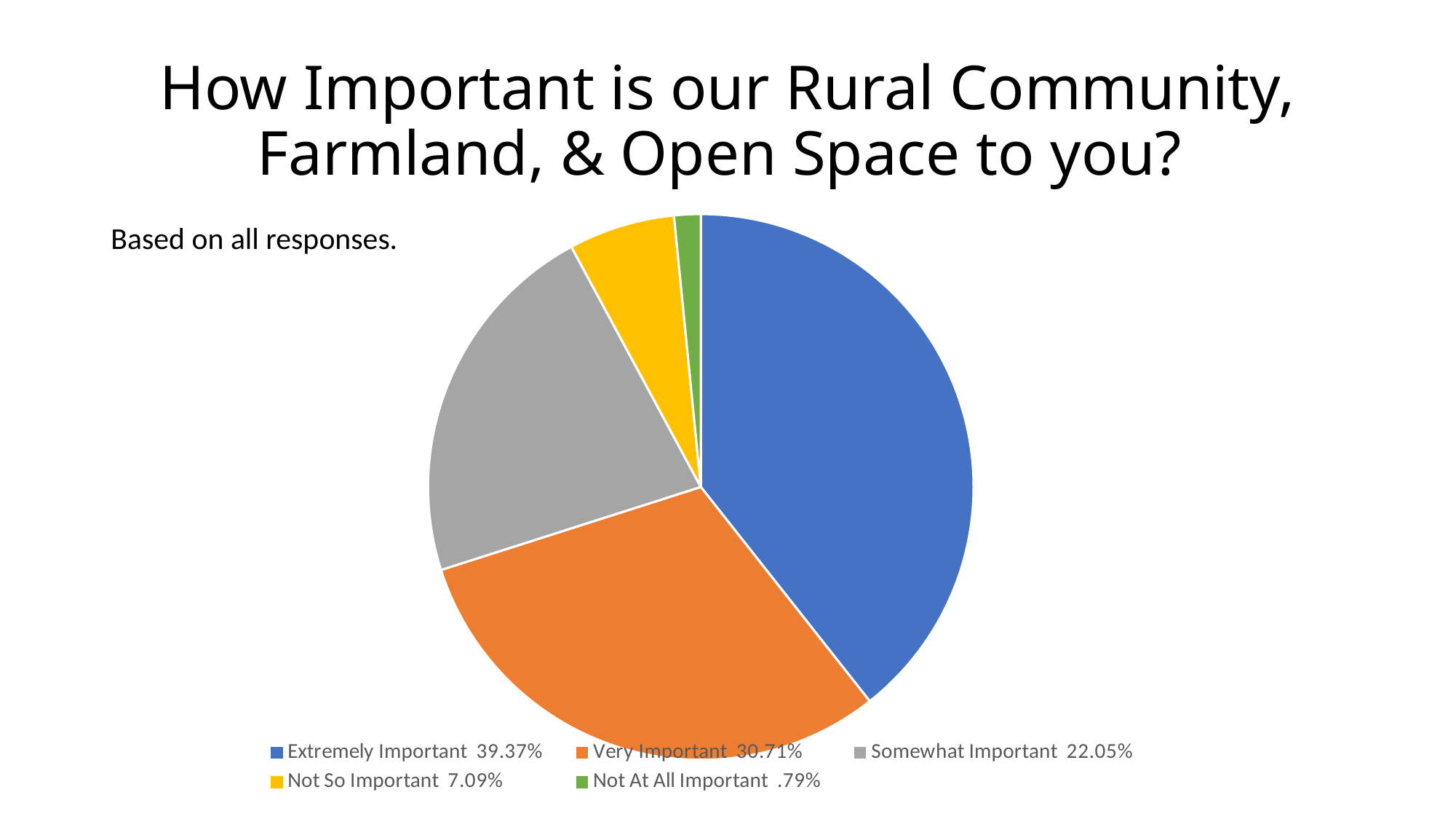
Which response category has the smallest share of the pie? Not At All Important What is the difference in percentage points between 'Extremely Important' and 'Very Important'? 8.66% What colour is the 'Somewhat Important' slice? grey What kind of chart is shown on the slide? pie chart How many response categories does the pie chart show? 5 What percentage of responses were 'Extremely Important'? 39.37% Which response category has the largest share of the pie? Extremely Important What percentage of responses were 'Not At All Important'? .79% What is the difference in percentage points between 'Somewhat Important' and 'Not So Important'? 14.96% Which is larger, the share for 'Somewhat Important' or the share for 'Not So Important'? Somewhat Important What percentage of responses were 'Very Important'? 30.71% What percentage of responses were 'Not So Important'? 7.09%